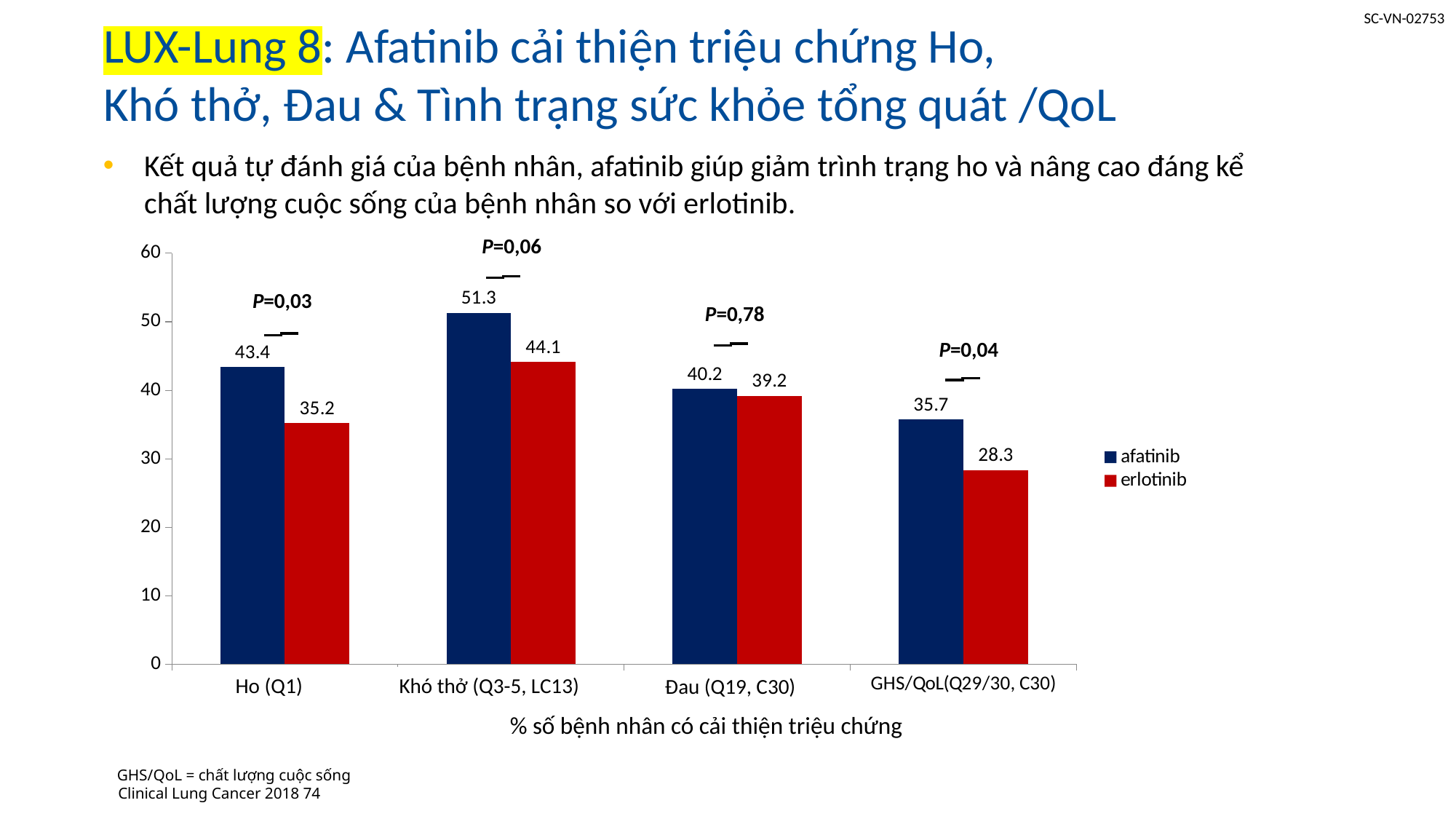
How many series does the legend list? 2 What is the difference between afatinib and erlotinib in the GHS/QoL(Q29/30, C30) category? 7.4 In which category does afatinib have its highest value? Khó thở (Q3-5, LC13) Which is larger in the Khó thở (Q3-5, LC13) category, afatinib or erlotinib? afatinib What is the value for erlotinib in the GHS/QoL(Q29/30, C30) category? 28.3 What is the value for erlotinib in the Khó thở (Q3-5, LC13) category? 44.1 How many categories are shown on the x axis? 4 What P value is shown above the Đau (Q19, C30) category? P=0,78 What is the value for afatinib in the Ho (Q1) category? 43.4 In which category does erlotinib have its lowest value? GHS/QoL(Q29/30, C30) What is the difference between afatinib and erlotinib in the Ho (Q1) category? 8.2 What kind of chart is shown on the slide? bar chart